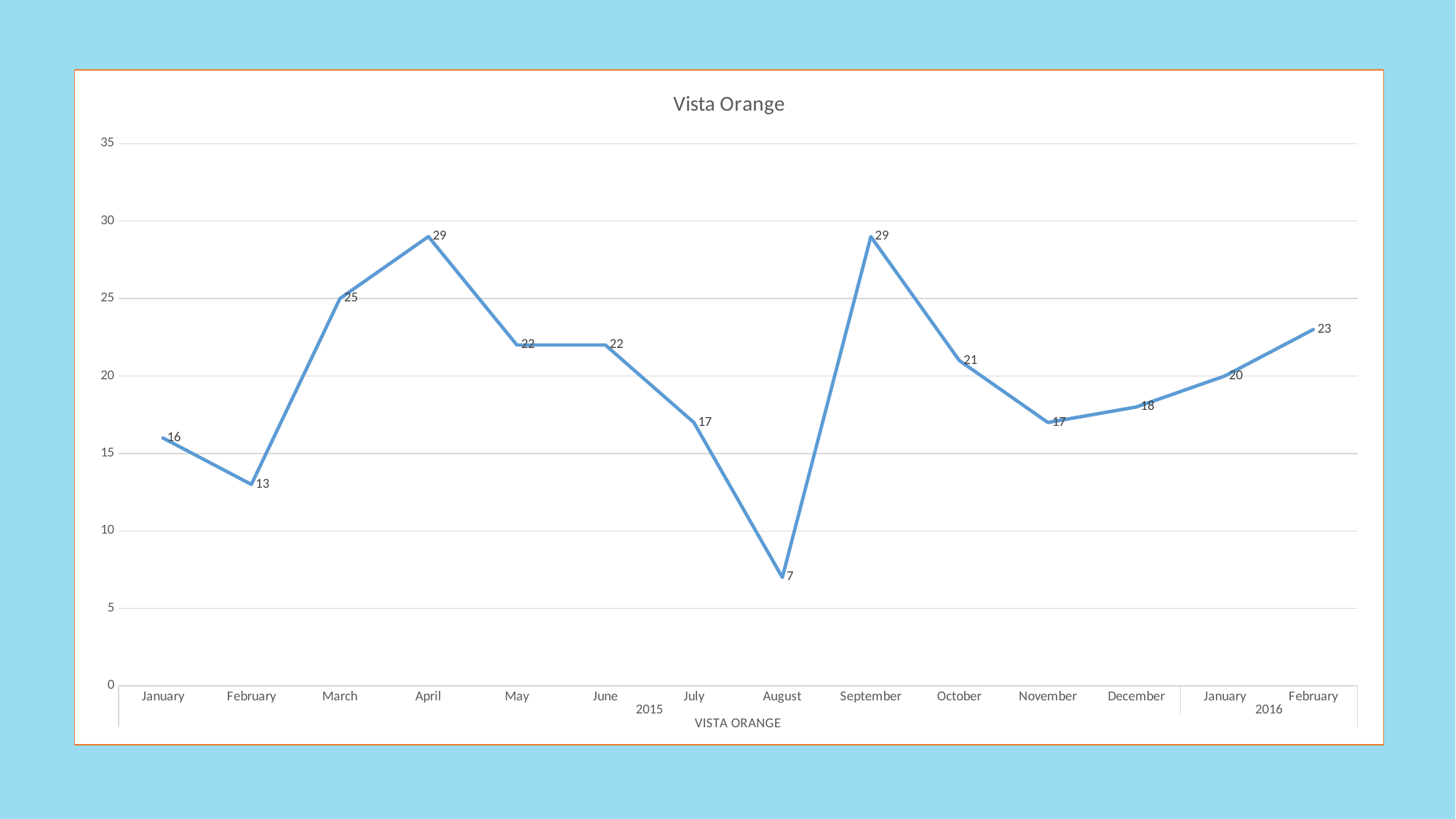
What is the value for August 2015? 7 What is the difference between the values for April 2015 and August 2015? 22 What is the title of the chart? Vista Orange What is the highest value shown on the vertical axis? 35 How many data points are plotted on the chart? 14 What is the value for February 2016? 23 Which month has the lowest value? August 2015 What is the difference between the values for January 2015 and February 2015? 3 What kind of chart is shown? Line chart What is the value for March 2015? 25 Which is larger, the value for October 2015 or the value for November 2015? October 2015 Do the values rise or fall from November 2015 to February 2016? Rise